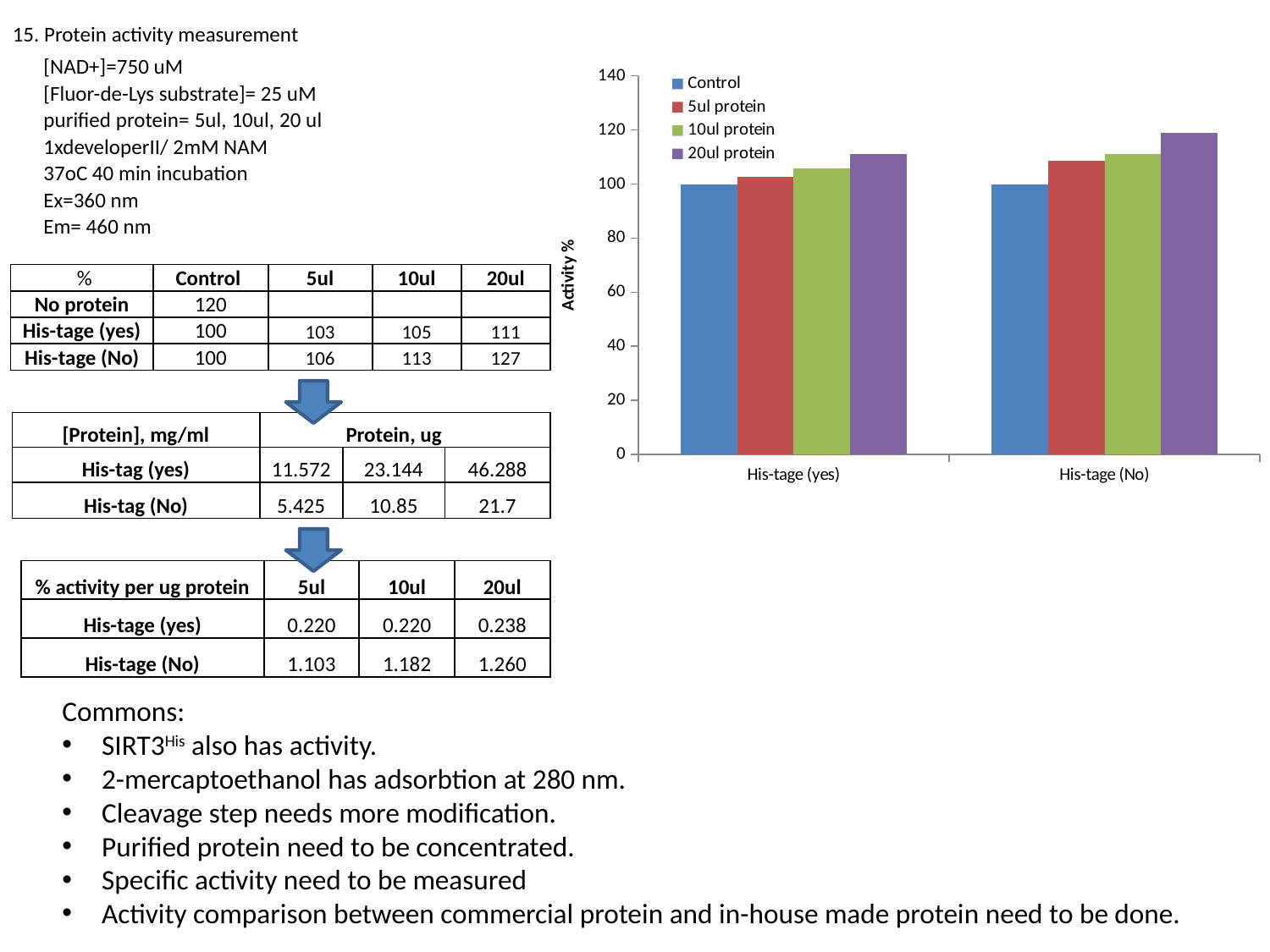
What is the Control value for His-tage (No) in the chart? 100 How many categories are shown on the x axis of the chart? 2 Which series has the shortest bar in the His-tage (yes) group? Control Which series has the tallest bar in the His-tage (No) group? 20ul protein How many series does the chart legend list? 4 What is the Control value for His-tage (yes) in the chart? 100 Which is larger: the 20ul protein value for His-tage (yes) or for His-tage (No)? His-tage (No) Within the His-tage (No) group, do the bars rise or fall from Control to 20ul protein? rise Is the 20ul protein value for His-tage (yes) greater or less than 120? less What is the y-axis label of the chart? Activity % Is the 20ul protein value for His-tage (No) greater or less than 100? greater What kind of chart is shown on the slide? bar chart